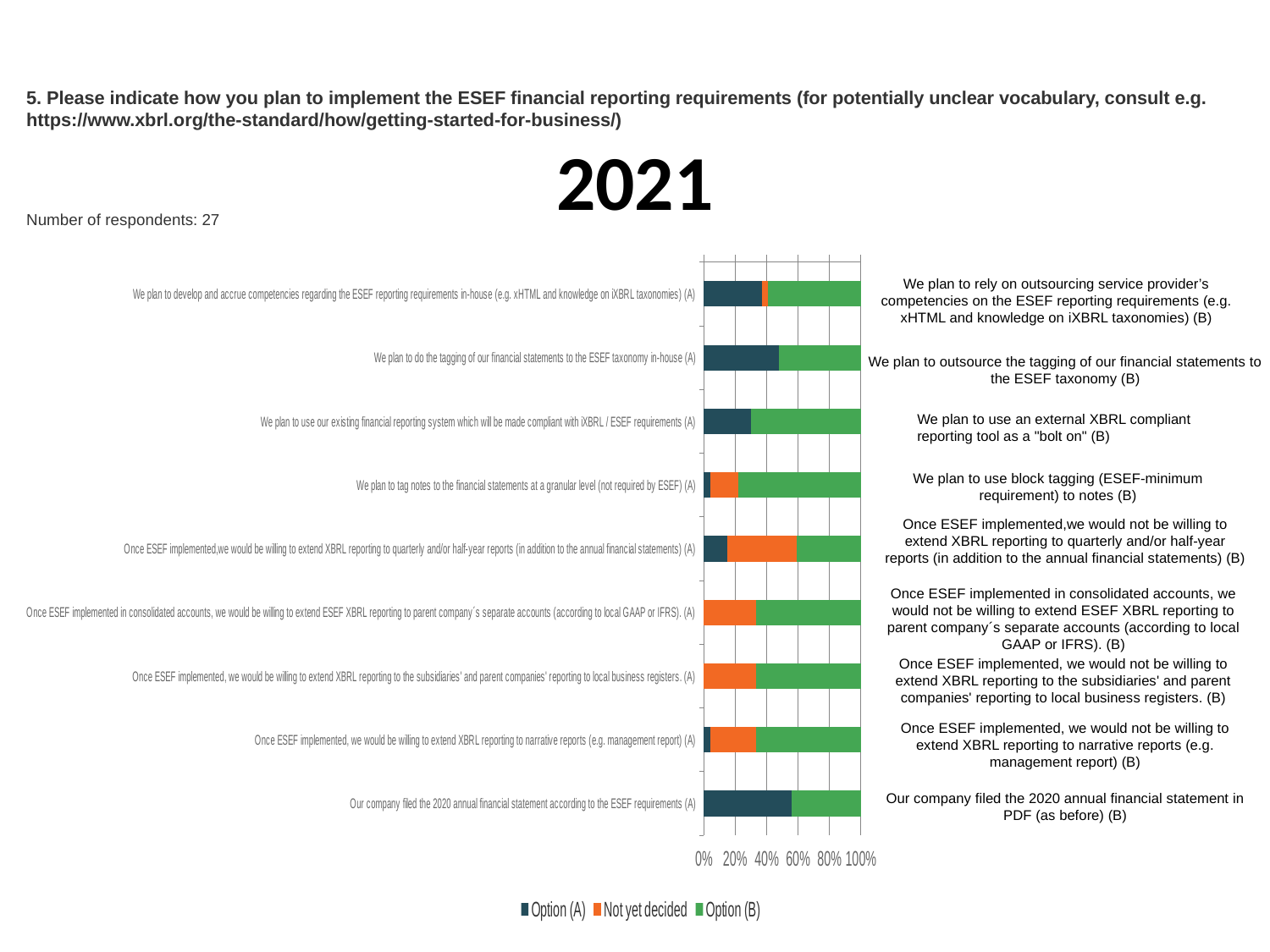
What is the title shown above the chart? 2021 How many series does the chart legend list? 3 Is the Option (A) share for "Our company filed the 2020 annual financial statement according to the ESEF requirements (A)" greater or less than 40%? greater How many categories (statements) are plotted in the chart? 9 What kind of chart is shown on the slide? Stacked bar chart Is the Option (A) share for "We plan to tag notes to the financial statements at a granular level (not required by ESEF) (A)" greater or less than 20%? less Is the Option (A) share for "We plan to do the tagging of our financial statements to the ESEF taxonomy in-house (A)" greater or less than 40%? greater Which has the larger Option (A) share: "We plan to do the tagging of our financial statements to the ESEF taxonomy in-house (A)" or "We plan to use our existing financial reporting system which will be made compliant with iXBRL / ESEF requirements (A)"? We plan to do the tagging of our financial statements to the ESEF taxonomy in-house (A) What are the three series named in the chart legend? Option (A), Not yet decided, Option (B) Which statement has the largest Option (A) share? Our company filed the 2020 annual financial statement according to the ESEF requirements (A)